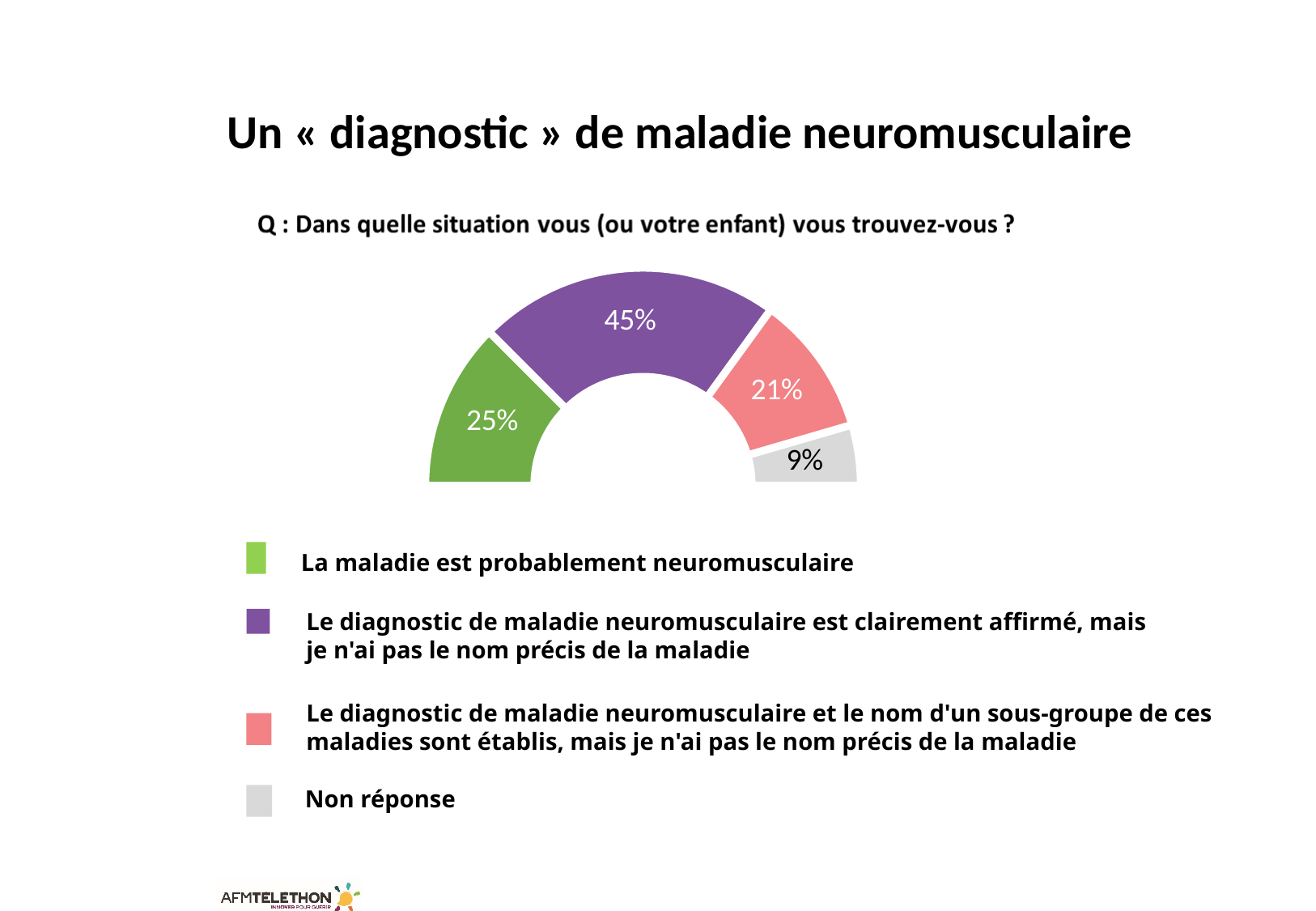
What percentage of respondents said the disease is probably neuromuscular ("La maladie est probablement neuromusculaire")? 25% What is the survey question shown above the chart? Q : Dans quelle situation vous (ou votre enfant) vous trouvez-vous ? Which response category has the smallest share? Non réponse Which is larger: the share for "La maladie est probablement neuromusculaire" or the share for the sub-group diagnosis category? La maladie est probablement neuromusculaire What kind of chart is shown on the slide? Semi-circular doughnut (pie) chart What percentage of respondents said the diagnosis and the name of a sub-group are established but they do not have the precise name of the disease? 21% What is the difference in percentage points between the largest segment (45%) and the "Non réponse" segment (9%)? 36 What percentage of respondents said the diagnosis of neuromuscular disease is clearly confirmed but they do not have the precise name of the disease? 45% What colour represents the "Non réponse" category? Grey Which response category has the largest share? Le diagnostic de maladie neuromusculaire est clairement affirmé, mais je n'ai pas le nom précis de la maladie What percentage of respondents gave no answer ("Non réponse")? 9% How many response categories are shown in the chart? 4